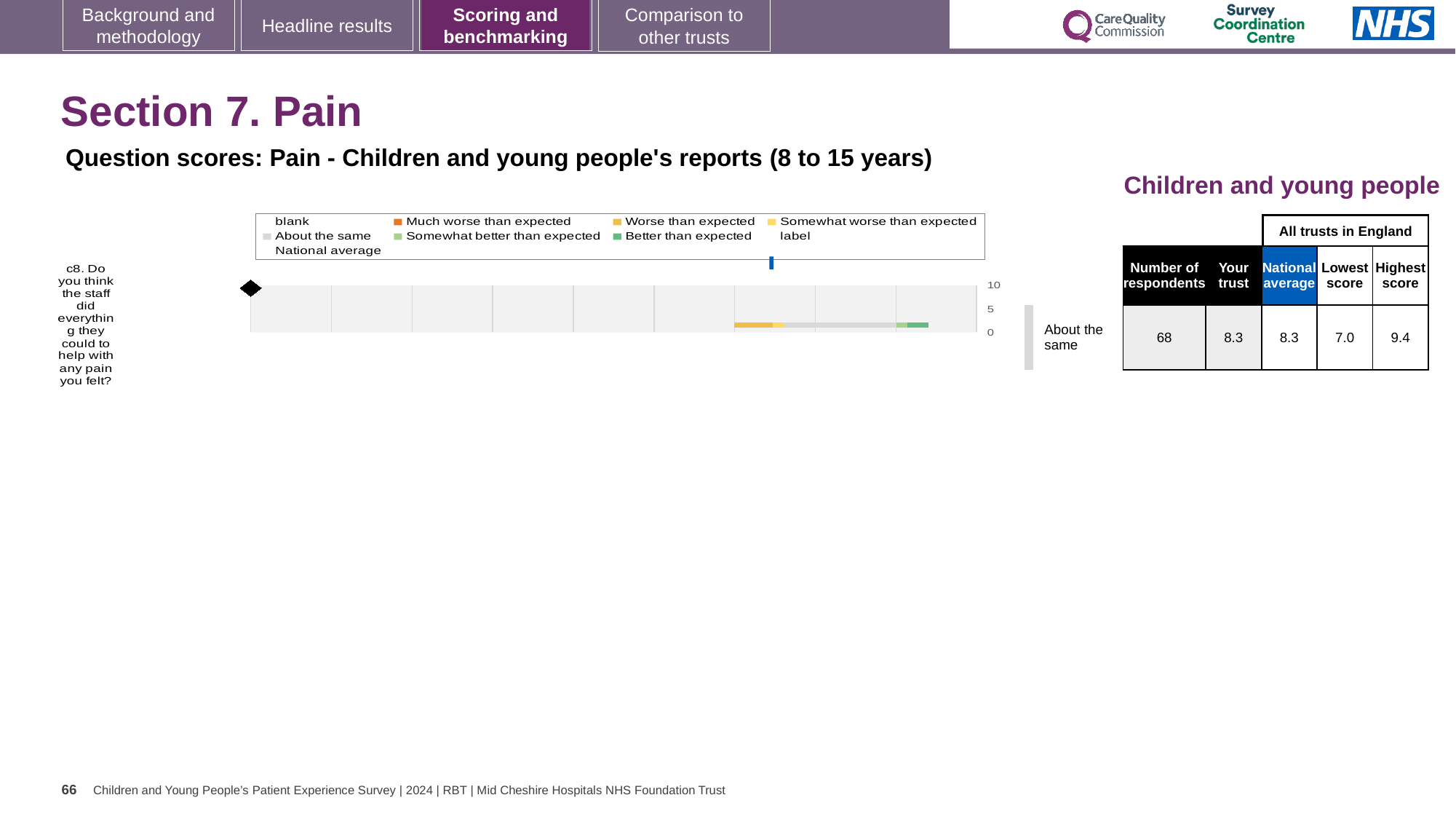
Which question is plotted in the chart? c8. Do you think the staff did everything they could to help with any pain you felt? How many survey questions are plotted in the chart? 1 What kind of chart is shown on the slide? bar chart What colour does the legend use for 'Better than expected'? green What is the difference between the highest score (9.4) and the lowest score (7.0) shown in the table for question c8? 2.4 According to the table beside the chart, how many respondents answered question c8? 68 According to the table beside the chart, what is the national average score for question c8? 8.3 Is the 'Your trust' score for question c8 larger than, smaller than, or equal to the national average? equal According to the table beside the chart, what is the 'Your trust' score for question c8? 8.3 According to the table beside the chart, what is the lowest score among all trusts in England for question c8? 7.0 What benchmark category is shown next to the chart for question c8? About the same According to the table beside the chart, what is the highest score among all trusts in England for question c8? 9.4